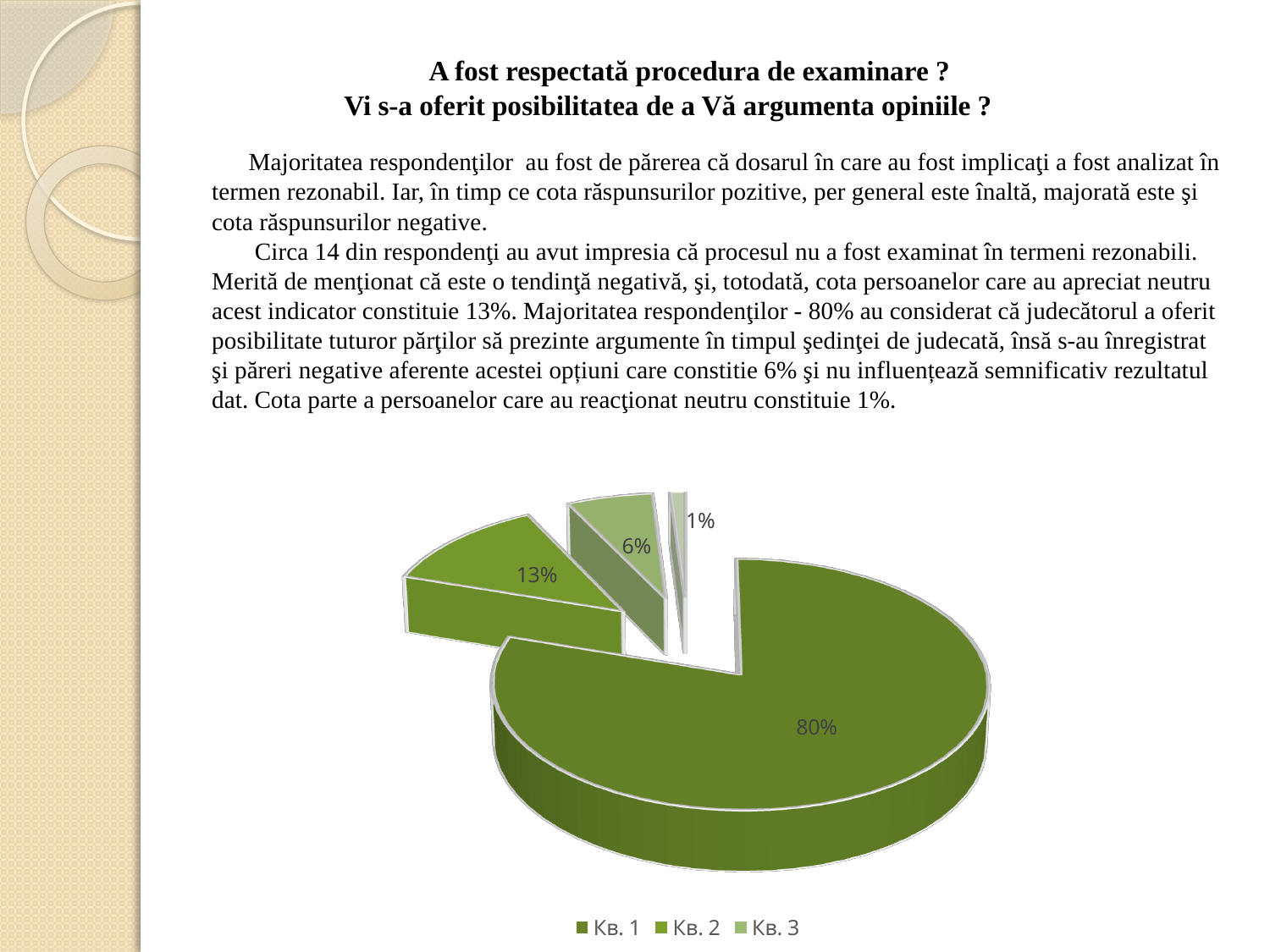
What is the difference between the largest slice (80%) and the 13% slice? 67% How many slices does the pie chart have? 4 Is the largest slice of the pie greater or less than 50%? greater What is the largest slice's share of the pie? 80% What is the combined share of the 13%, 6% and 1% slices? 20% What is the share of the slice labelled Кв. 1 in the legend (the dark green slice)? 80% Which is larger, the 6% slice or the 13% slice? 13% What is the difference between the 13% slice and the 6% slice? 7% What kind of chart is shown on the slide? pie chart What are the three legend entries of the pie chart? Кв. 1, Кв. 2, Кв. 3 What is the smallest slice's share of the pie? 1% How many entries does the legend list? 3